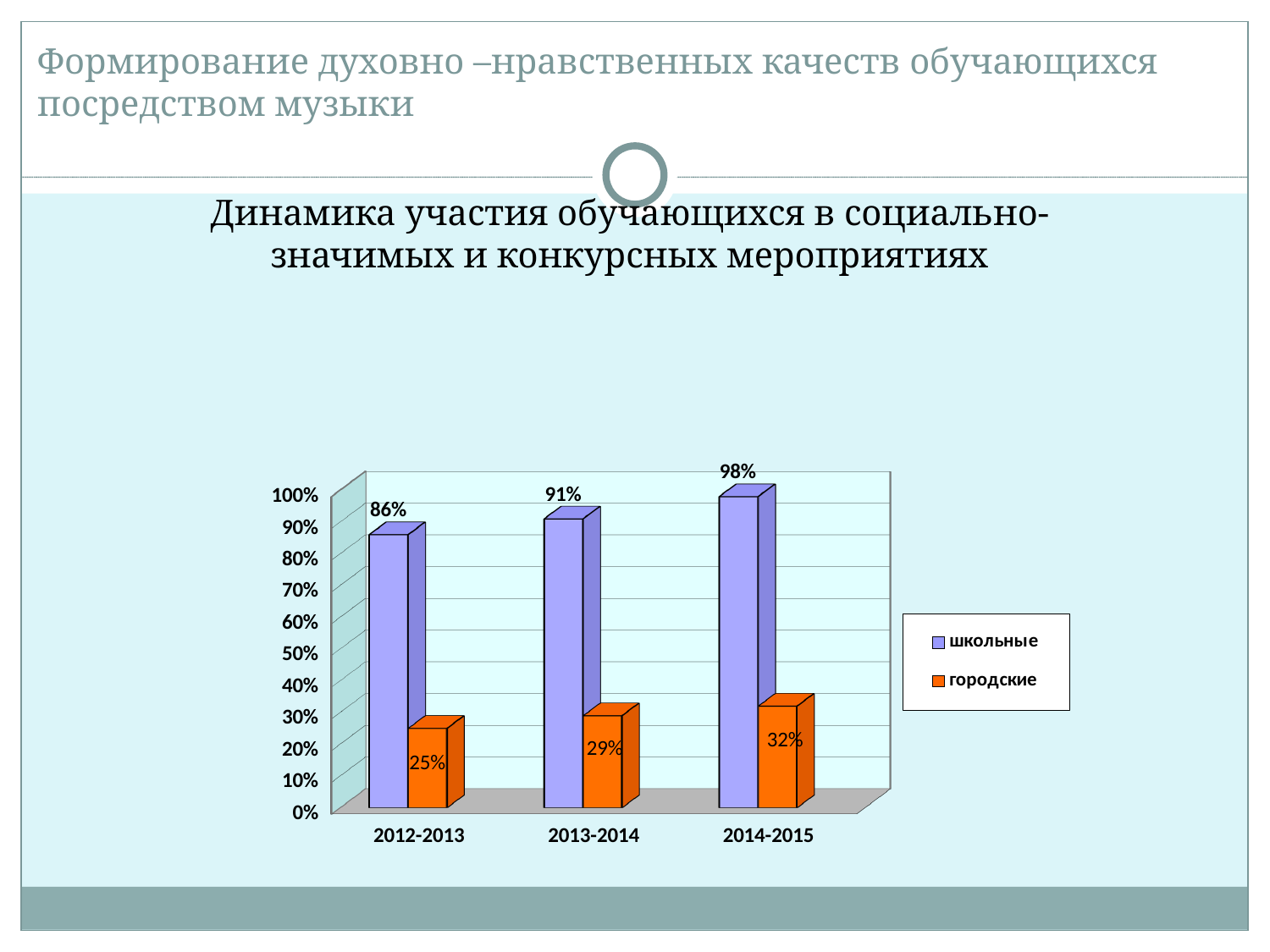
What kind of chart is shown on the slide? bar chart By how much did the value for школьные increase from 2012-2013 to 2014-2015? 12% What is the value for школьные in 2012-2013? 86% How many year categories are shown on the x axis? 3 What is the difference between школьные and городские in 2014-2015? 66% Do the values for городские rise or fall from 2012-2013 to 2014-2015? rise What is the value for городские in 2014-2015? 32% How many series does the legend list? 2 What is the value for городские in 2013-2014? 29% In which year is the value for городские lowest? 2012-2013 In which year is the value for школьные highest? 2014-2015 Which is larger in 2013-2014, школьные or городские? школьные